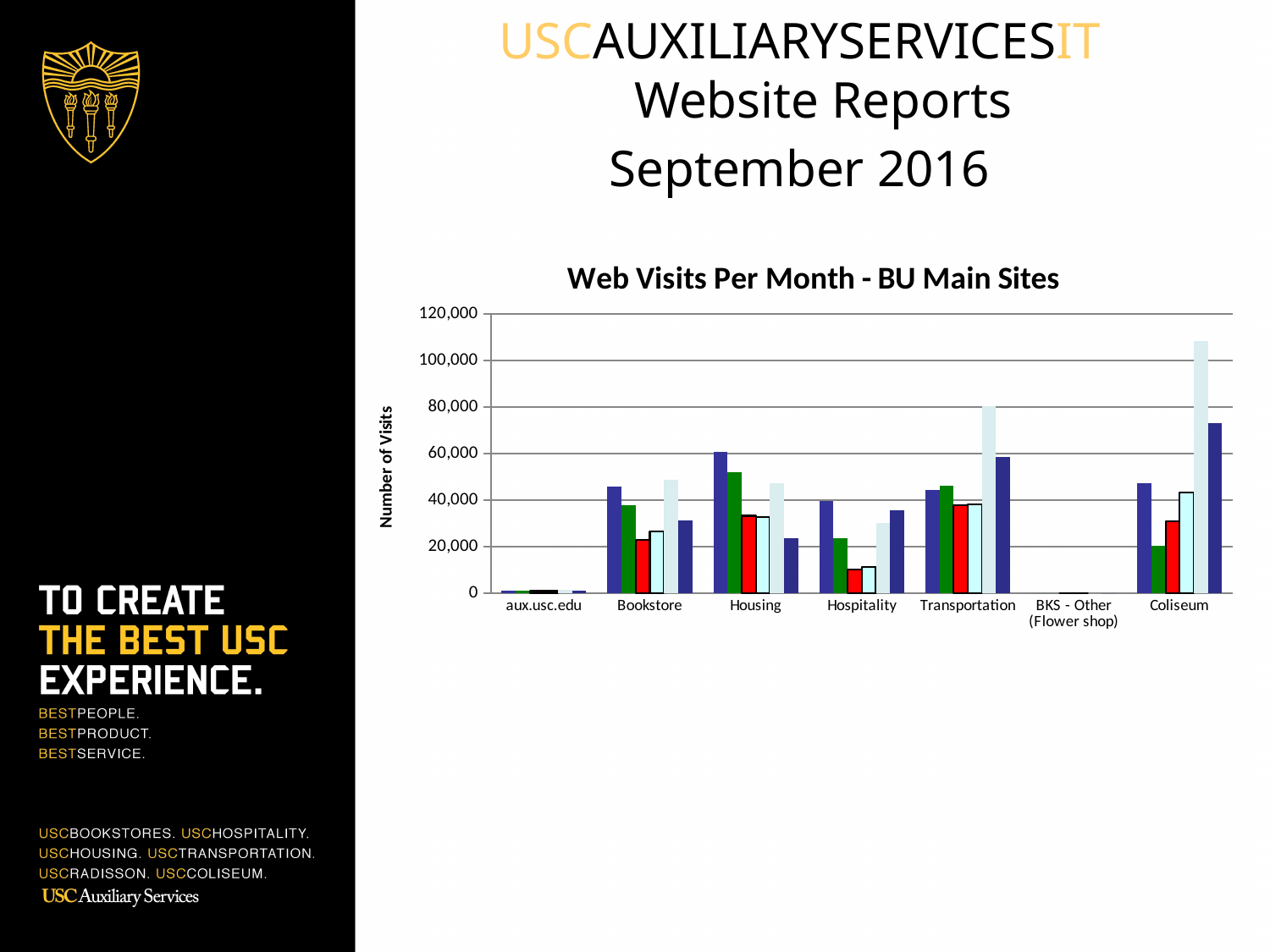
Is the last (navy) bar for Coliseum greater or less than 60,000? greater How many categories are shown along the x axis of the chart? 7 Is the tallest bar for Coliseum greater or less than 100,000? greater Is the red bar for Hospitality greater or less than 20,000? less What kind of chart is shown on the slide? bar chart What is the label on the vertical axis of the chart? Number of Visits What is the title of the chart? Web Visits Per Month - BU Main Sites Which has the taller light blue bar, Coliseum or Transportation? Coliseum Which has the taller first (dark blue) bar, Housing or Bookstore? Housing Which category contains the tallest bar in the chart? Coliseum